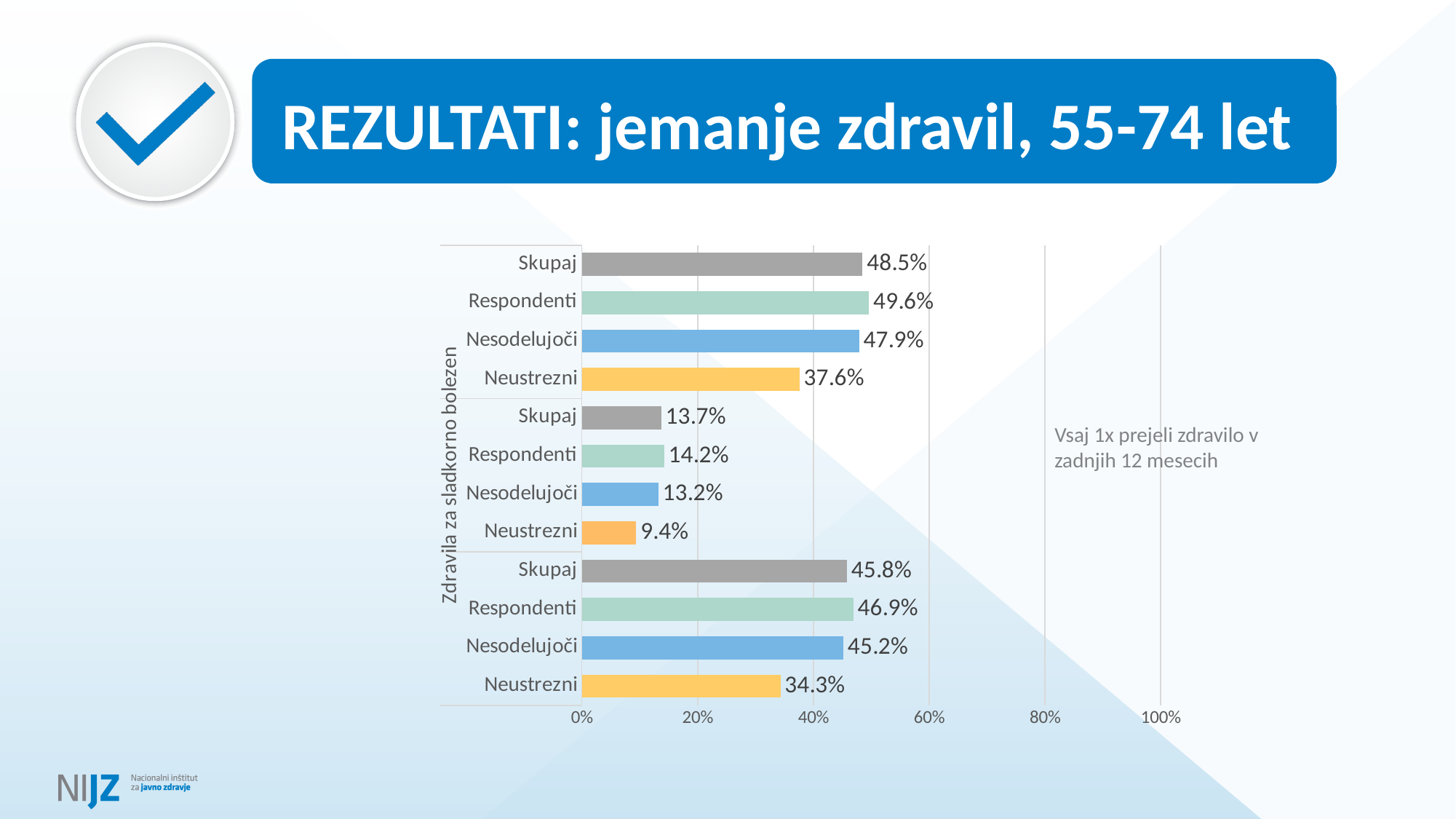
In the top group of bars, what is the difference between Respondenti and Neustrezni? 12.0% In the top group of bars, what is the value for Respondenti? 49.6% What does the text to the right of the chart say? Vsaj 1x prejeli zdravilo v zadnjih 12 mesecih In the bottom group of bars, what is the value for Nesodelujoči? 45.2% Which bar has the lowest value on the whole chart? Neustrezni (Zdravila za sladkorno bolezen), 9.4% Which bar has the highest value on the whole chart? Respondenti in the top group, 49.6% In the group labelled 'Zdravila za sladkorno bolezen', what is the value for Skupaj? 13.7% In the bottom group of bars, is the value for Neustrezni greater or less than 40%? less How many bars are plotted on the chart in total? 12 In the group labelled 'Zdravila za sladkorno bolezen', which is larger: Respondenti or Nesodelujoči? Respondenti In the group labelled 'Zdravila za sladkorno bolezen', what is the value for Neustrezni? 9.4% What kind of chart is shown on the slide? bar chart